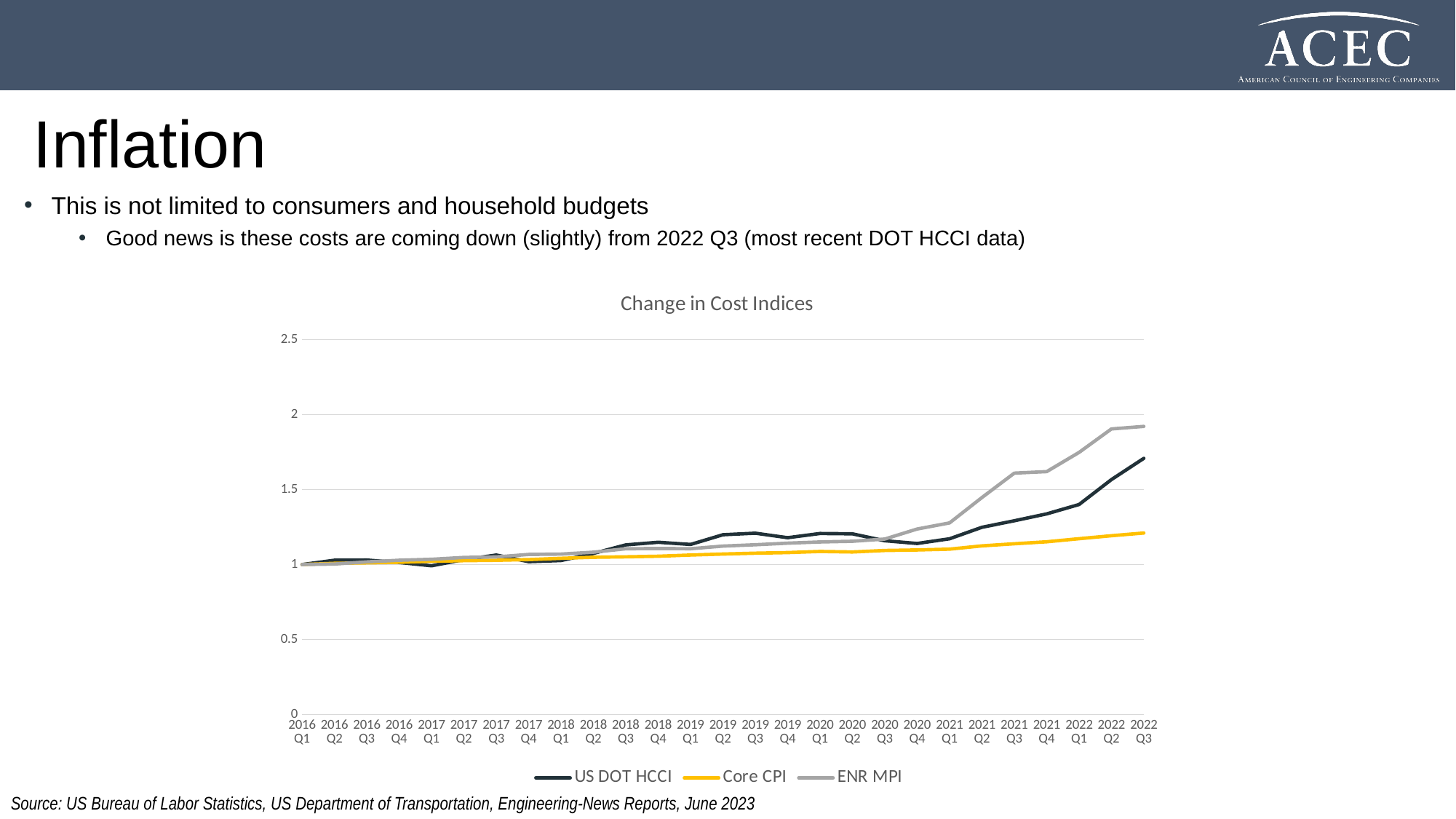
At 2022 Q2, which is larger: ENR MPI or US DOT HCCI? ENR MPI How many series does the chart's legend list? 3 Does the ENR MPI series generally rise or fall from 2016 Q1 to 2022 Q3? Rise Is the value for Core CPI at 2022 Q3 greater or less than 1.5? less What is the title of the chart? Change in Cost Indices Which colour is used for the Core CPI line in the chart? Yellow Which series has the highest value at 2022 Q3? ENR MPI Is the value for ENR MPI at 2022 Q3 greater or less than 1.5? greater Which series has the lowest value at 2022 Q3? Core CPI How many quarterly points are plotted along the x axis of the chart? 27 What type of chart is shown on the slide? Line chart Is the value for US DOT HCCI at 2022 Q3 greater or less than 1.5? greater